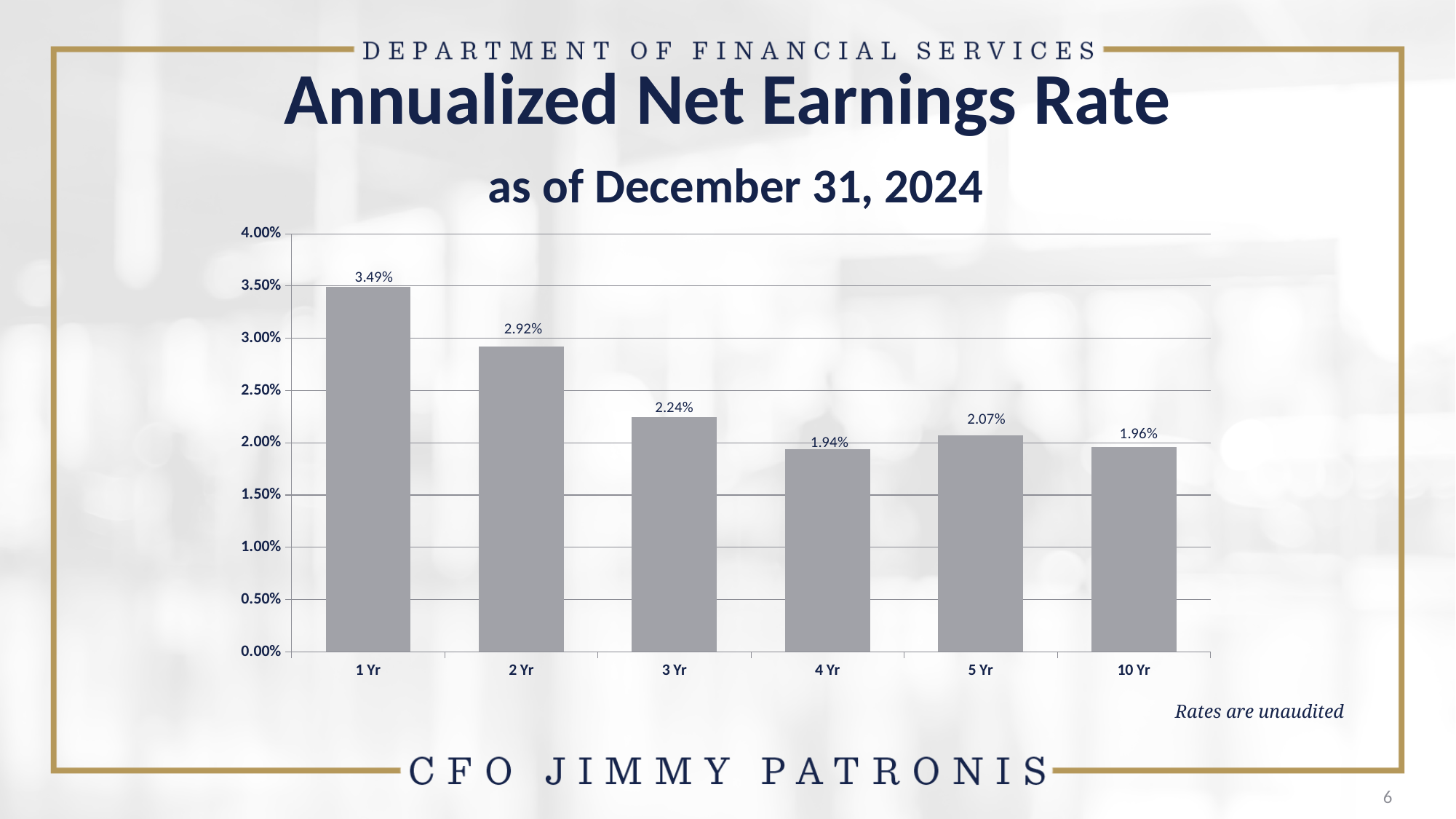
What kind of chart is shown on the slide? bar chart Which period has the highest annualized net earnings rate? 1 Yr Which is larger, the 5 Yr rate or the 10 Yr rate? 5 Yr What is the title of the chart on the slide? Annualized Net Earnings Rate as of December 31, 2024 How many periods are shown on the chart? 6 What is the annualized net earnings rate for 3 Yr? 2.24% What is the difference between the 1 Yr and 2 Yr annualized net earnings rates? 0.57% Is the value for 2 Yr greater or less than 3.00%? less What is the annualized net earnings rate for 10 Yr? 1.96% Do the values generally rise or fall from 1 Yr to 4 Yr? fall Which period has the lowest annualized net earnings rate? 4 Yr What is the annualized net earnings rate for 1 Yr? 3.49%